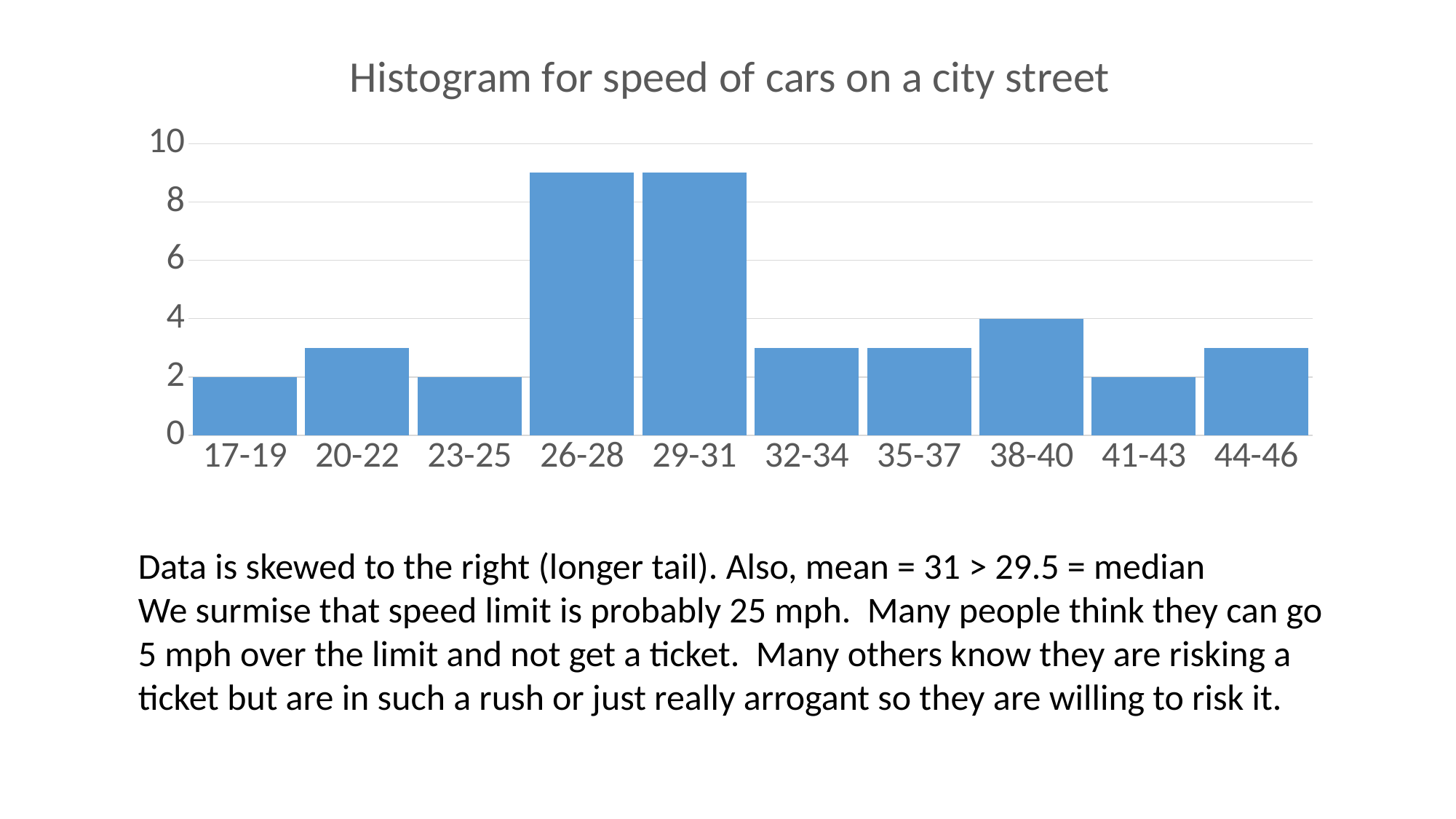
What is the value for the 17-19 category? 2 How many speed categories are shown on the x axis? 10 What is the value for the 38-40 category? 4 Which is larger, the value for 38-40 or the value for 41-43? 38-40 Is the value for 20-22 greater or less than 4? less Is the value for 26-28 greater or less than 8? greater What is the value for the 41-43 category? 2 Is the value for 44-46 greater or less than 2? greater Which is larger, the value for 29-31 or the value for 32-34? 29-31 What is the title of the chart? Histogram for speed of cars on a city street What is the difference between the values for 38-40 and 41-43? 2 What is the value for the 23-25 category? 2